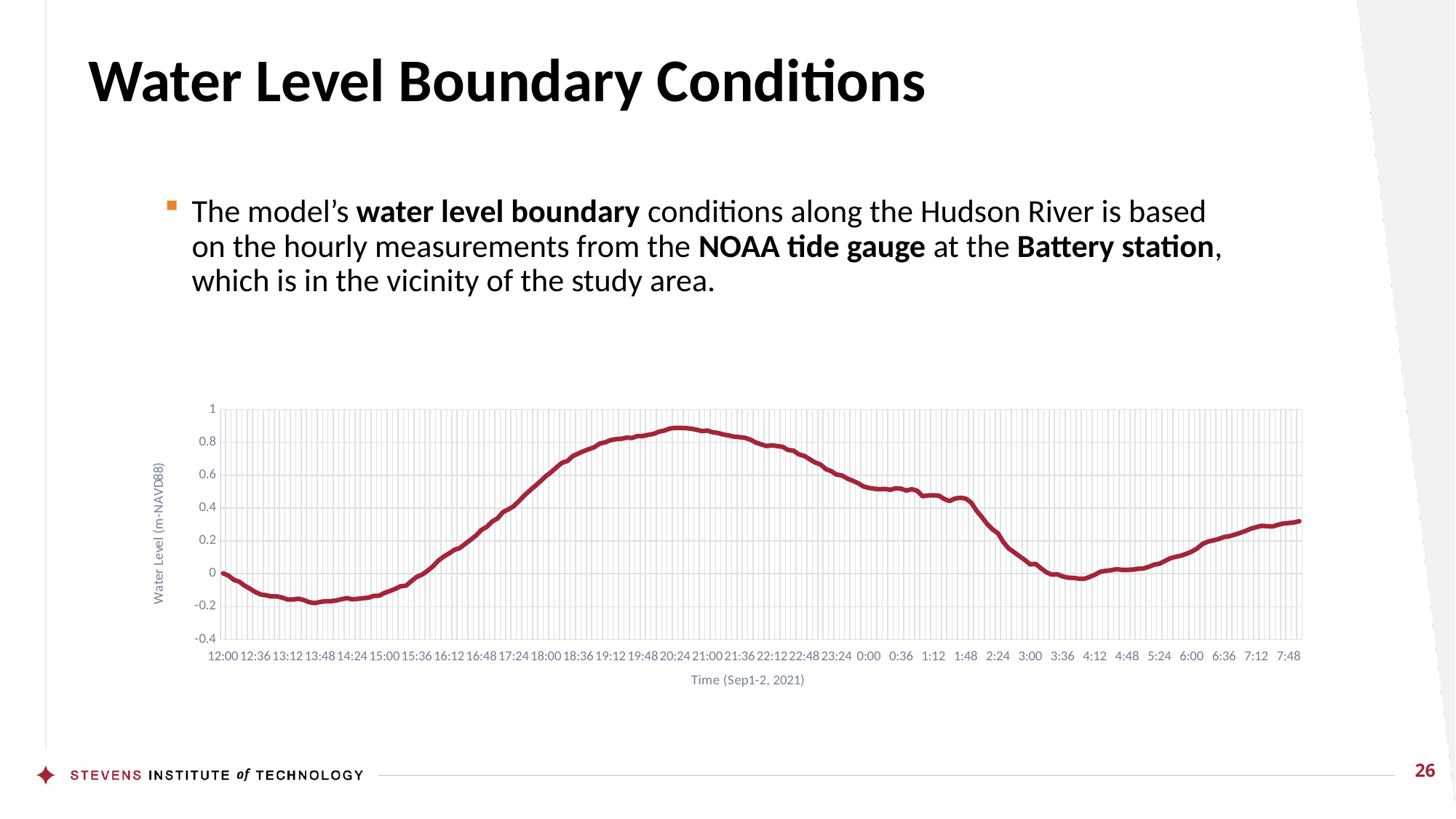
What is the label of the vertical axis? Water Level (m-NAVD88) Is the water level at 13:48 greater or less than 0? less Is the lowest water level on the chart greater or less than 0? less Which is larger, the water level at 20:24 or at 12:00? 20:24 Is the water level at 7:48 greater or less than 0.2? greater What kind of chart is shown on the slide? line chart Does the water level rise or fall between 21:00 and 3:00? fall Which is larger, the water level at 13:48 or at 7:48? 7:48 Does the water level rise or fall between 15:36 and 19:48? rise